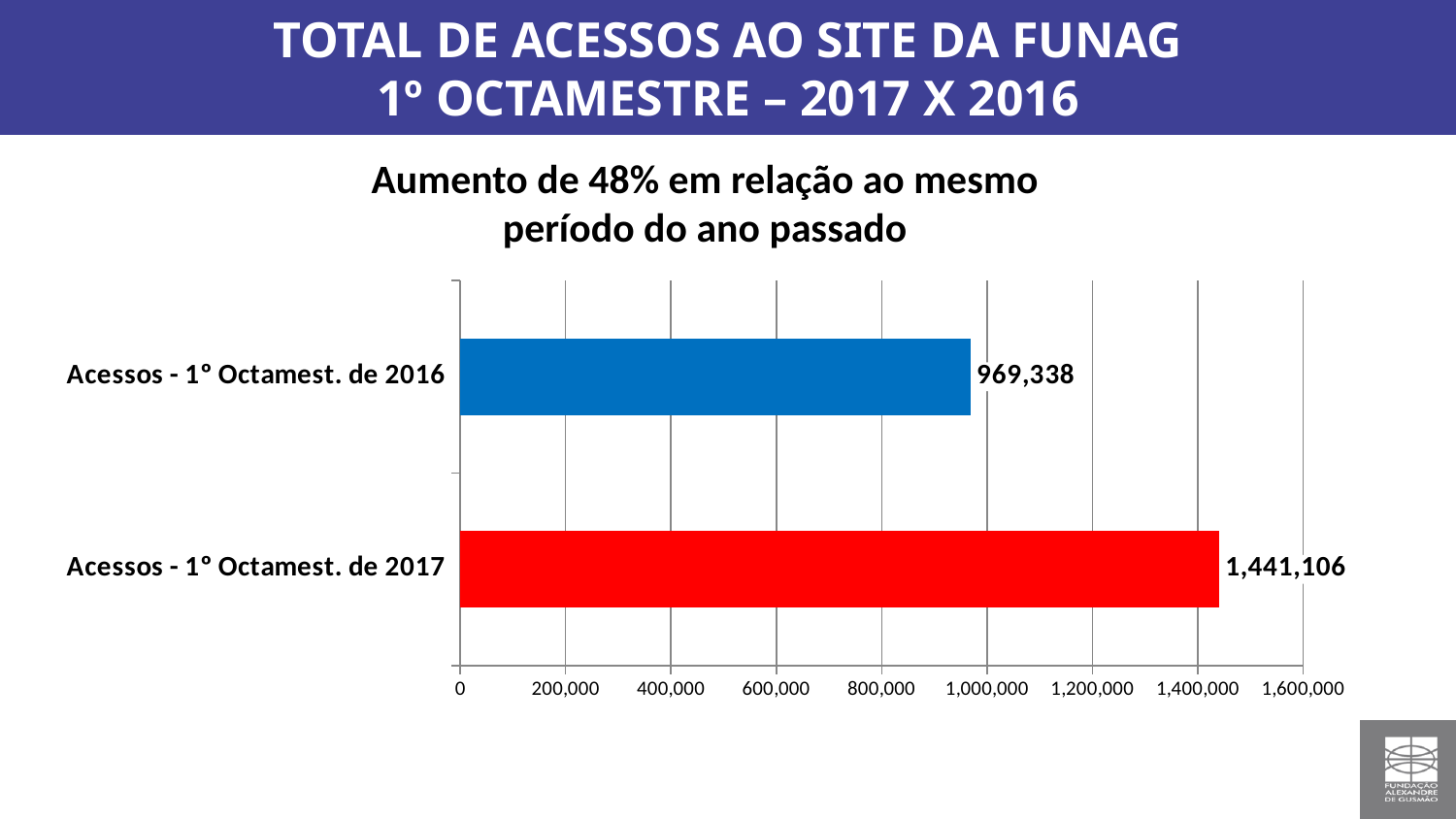
Is the value for "Acessos - 1° Octamest. de 2016" greater or less than 1,000,000? less Which is larger, the value for "Acessos - 1° Octamest. de 2016" or the value for "Acessos - 1° Octamest. de 2017"? Acessos - 1° Octamest. de 2017 What is the value for "Acessos - 1° Octamest. de 2016"? 969,338 What is the title of the chart? Aumento de 48% em relação ao mesmo período do ano passado What is the value for "Acessos - 1° Octamest. de 2017"? 1,441,106 What colour is the bar for "Acessos - 1° Octamest. de 2017"? Red What is the difference between the value for 2017 and the value for 2016? 471,768 Is the value for "Acessos - 1° Octamest. de 2017" greater or less than 1,400,000? greater Which category has the highest value? Acessos - 1° Octamest. de 2017 How many categories are shown in the chart? 2 Which category has the lowest value? Acessos - 1° Octamest. de 2016 What kind of chart is shown on the slide? Bar chart